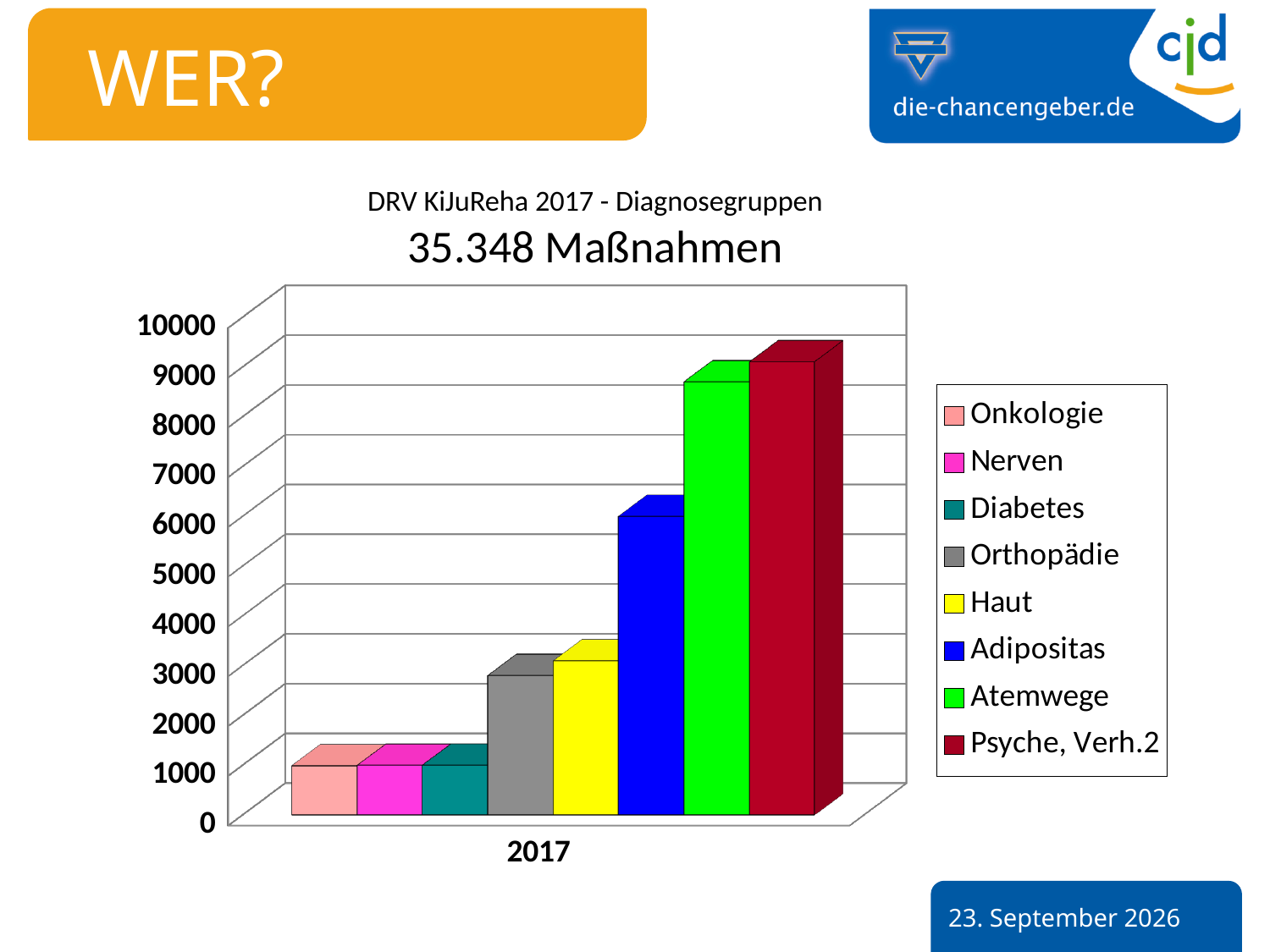
Is the value for Adipositas greater or less than 5000? greater Is the value for Haut greater or less than 2000? greater What kind of chart is shown on the slide? bar chart Is the value for Orthopädie greater or less than 4000? less Which diagnosis group has the highest value? Psyche, Verh.2 What is the title of the chart? DRV KiJuReha 2017 - Diagnosegruppen 35.348 Maßnahmen How many categories are shown on the x axis? 1 What colour is the bar for Adipositas? blue Which is larger, the value for Adipositas or the value for Haut? Adipositas How many series does the legend list? 8